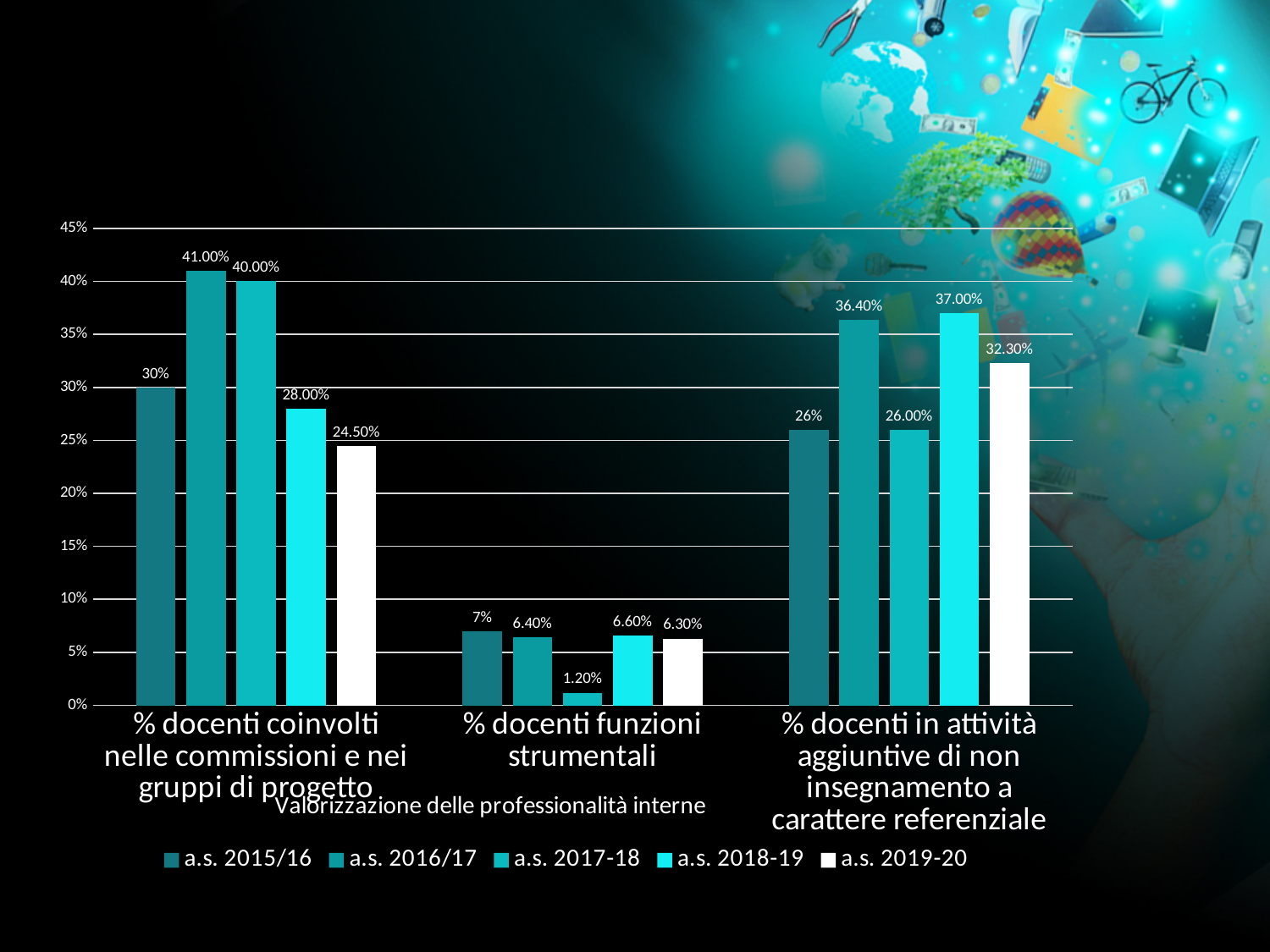
What is the value for a.s. 2019-20 in the category '% docenti in attività aggiuntive di non insegnamento a carattere referenziale'? 32.30% What is the value for a.s. 2017-18 in the category '% docenti funzioni strumentali'? 1.20% Which series has the lowest value in the category '% docenti coinvolti nelle commissioni e nei gruppi di progetto'? a.s. 2019-20 What is the value for a.s. 2016/17 in the category '% docenti coinvolti nelle commissioni e nei gruppi di progetto'? 41.00% How many categories are shown on the x axis of the chart? 3 How many series does the legend list? 5 What is the axis title shown below the categories of the chart? Valorizzazione delle professionalità interne What kind of chart is shown on the slide? bar chart Which series has the highest value in the category '% docenti in attività aggiuntive di non insegnamento a carattere referenziale'? a.s. 2018-19 In the category '% docenti funzioni strumentali', which is larger: the a.s. 2015/16 value or the a.s. 2018-19 value? a.s. 2015/16 What is the difference between the a.s. 2016/17 and a.s. 2019-20 values in the category '% docenti coinvolti nelle commissioni e nei gruppi di progetto'? 16.50% Is the a.s. 2018-19 value in the category '% docenti in attività aggiuntive di non insegnamento a carattere referenziale' greater or less than 35%? greater